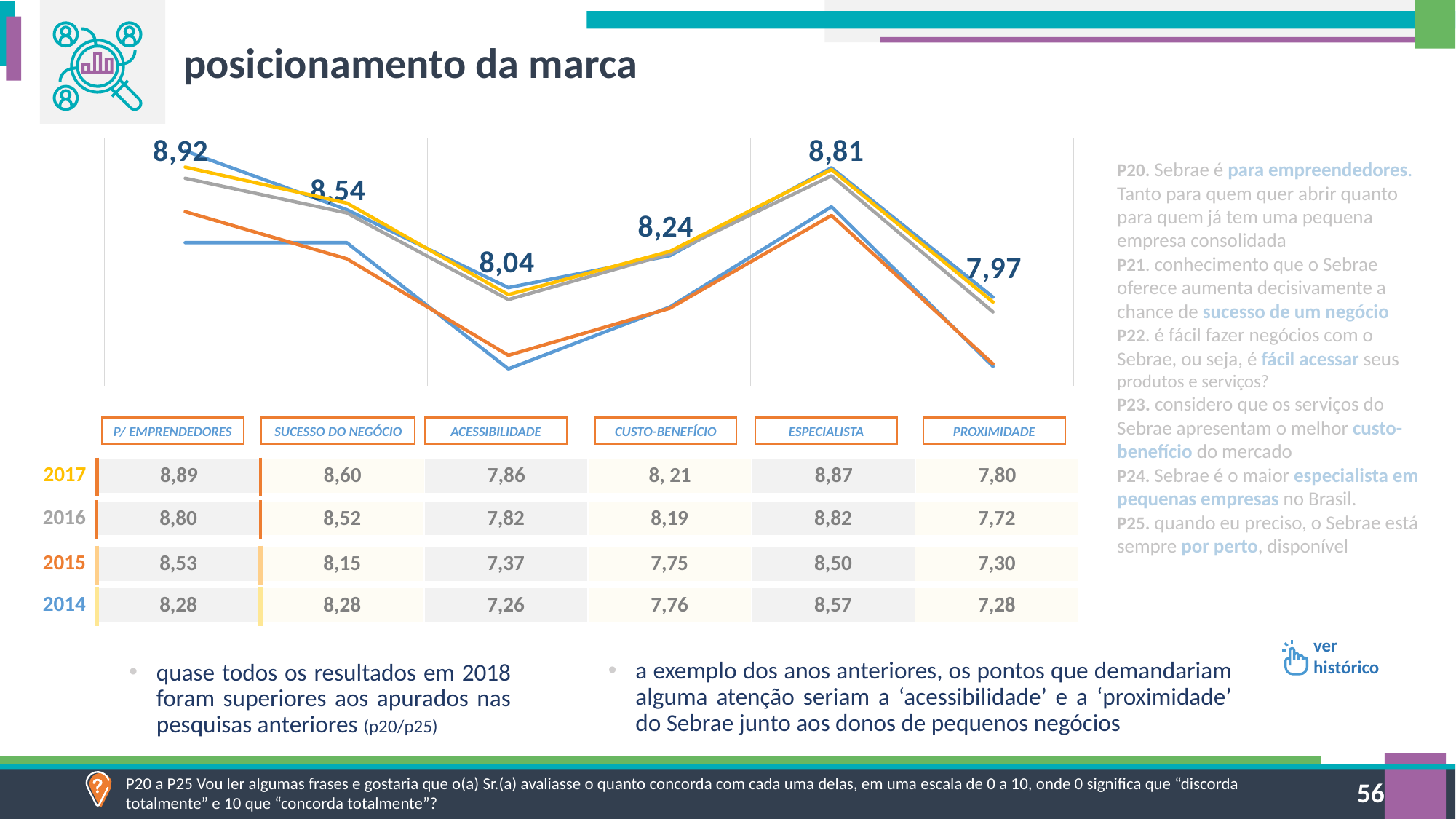
According to the table below the chart, what was the 2017 value for ESPECIALISTA? 8,87 What is the difference between the 2018 labelled value (8,92) and the 2017 table value for P/ EMPRENDEDORES? 0,03 Do the labelled 2018 values rise or fall from ACESSIBILIDADE to ESPECIALISTA? Rise How many categories are plotted along the x axis of the line chart? 6 Which category has the lowest labelled 2018 value on the line chart? PROXIMIDADE What is the 2018 value labelled for ACESSIBILIDADE on the line chart? 8,04 What kind of chart is shown on the slide? Line chart What is the difference between the labelled 2018 values for P/ EMPRENDEDORES and PROXIMIDADE? 0,95 What is the title of the slide containing the chart? posicionamento da marca What is the 2018 value labelled for ESPECIALISTA on the line chart? 8,81 Which has the larger labelled 2018 value: SUCESSO DO NEGÓCIO or CUSTO-BENEFÍCIO? SUCESSO DO NEGÓCIO Which category has the highest labelled 2018 value on the line chart? P/ EMPRENDEDORES